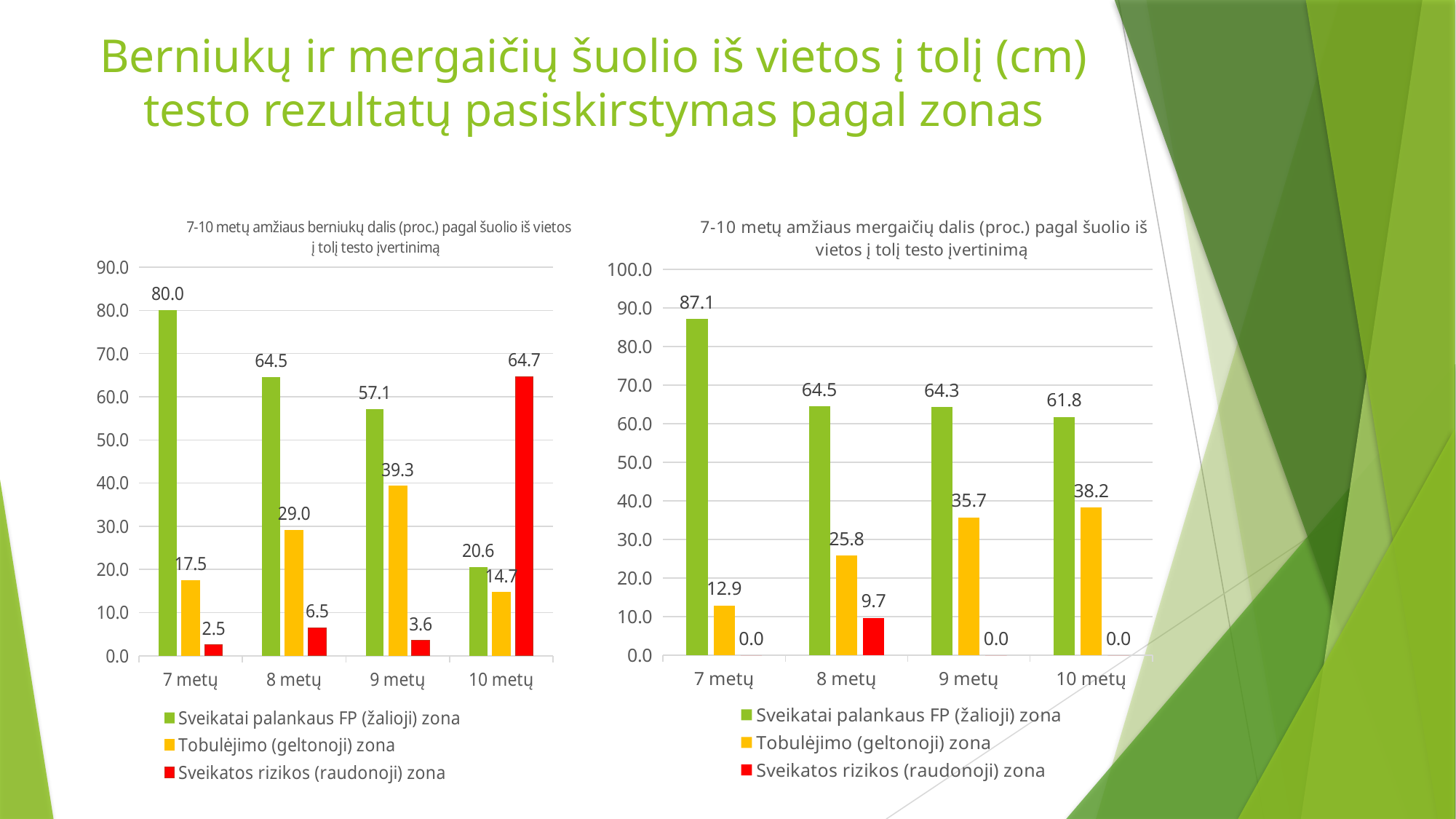
In the right chart (mergaičių), which age group has the highest value for the Sveikatai palankaus FP (žalioji) zona series? 7 metų How many age groups are shown on the x axis of the right chart (mergaičių)? 4 How many series does the legend of the left chart (berniukų) list? 3 In the left chart (berniukų), what is the value of the Sveikatos rizikos (raudonoji) zona series for 10 metų? 64.7 What kind of chart is the right chart (mergaičių)? Bar chart In the left chart (berniukų), what is the value of the Sveikatai palankaus FP (žalioji) zona series for 7 metų? 80.0 In the right chart (mergaičių), what is the value of the Tobulėjimo (geltonoji) zona series for 10 metų? 38.2 In the left chart (berniukų), which age group has the lowest value for the Sveikatos rizikos (raudonoji) zona series? 7 metų In the left chart (berniukų), for 10 metų, which is larger: the Sveikatai palankaus FP (žalioji) zona value or the Sveikatos rizikos (raudonoji) zona value? Sveikatos rizikos (raudonoji) zona In the left chart (berniukų), what is the difference between the Sveikatai palankaus FP (žalioji) zona values for 7 metų and 8 metų? 15.5 In the right chart (mergaičių), does the Sveikatai palankaus FP (žalioji) zona value rise or fall from 7 metų to 10 metų? Fall In the right chart (mergaičių), what is the difference between the Tobulėjimo (geltonoji) zona values for 9 metų and 7 metų? 22.8